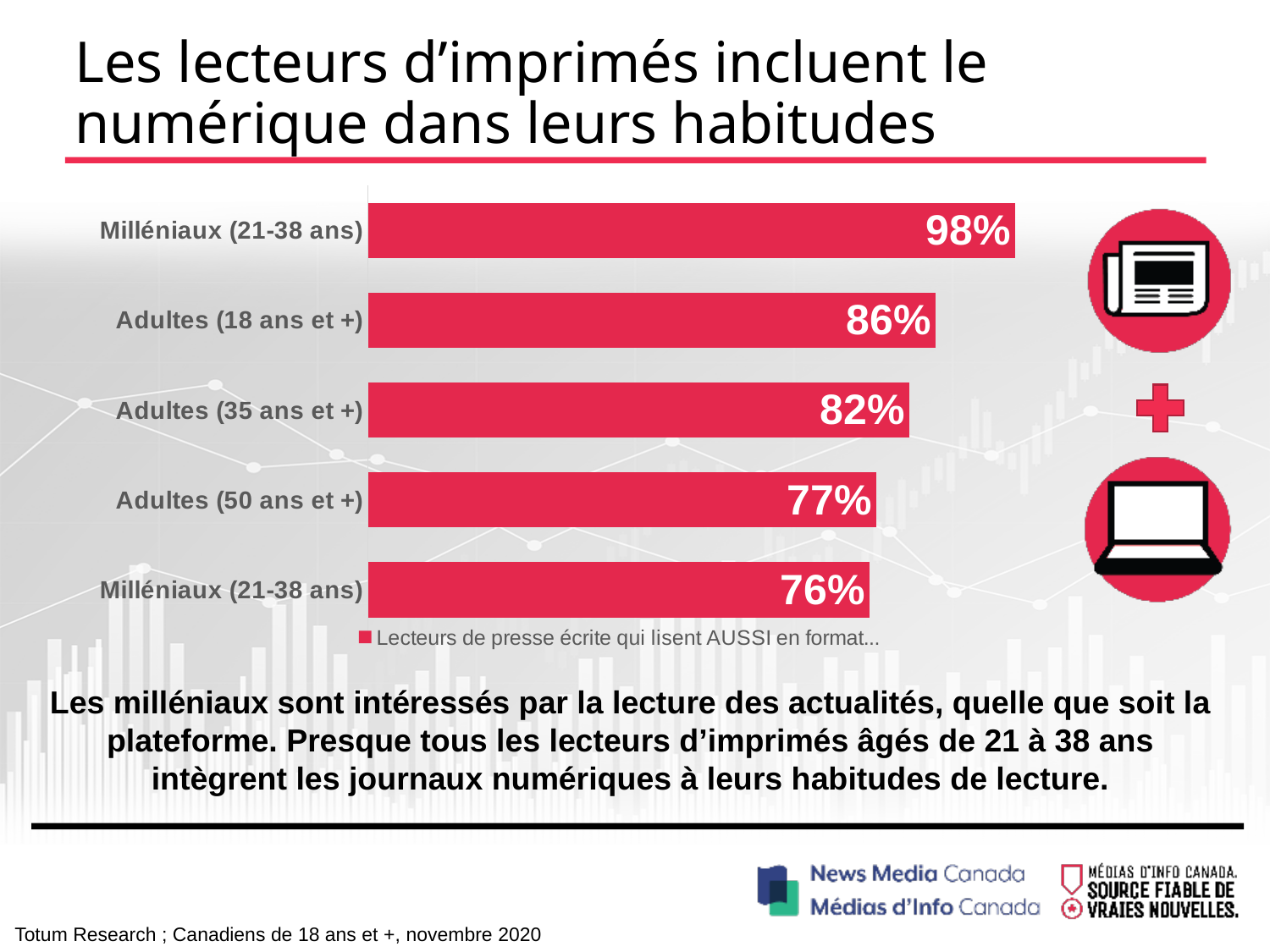
What value is shown on the top bar, labelled Milléniaux (21-38 ans)? 98% How many bars are shown in the chart? 5 What value is shown on the bottom bar, labelled Milléniaux (21-38 ans)? 76% What value is shown for Adultes (50 ans et +)? 77% What is the difference between the values for Adultes (18 ans et +) and Adultes (35 ans et +)? 4 percentage points What value is shown for Adultes (18 ans et +)? 86% How many series does the legend list? 1 What value is shown for Adultes (35 ans et +)? 82% What is the lowest value shown in the chart? 76% What is the highest value shown in the chart? 98% Which is larger, the value for Adultes (50 ans et +) or the value for Adultes (35 ans et +)? Adultes (35 ans et +) What kind of chart is shown on the slide? Bar chart